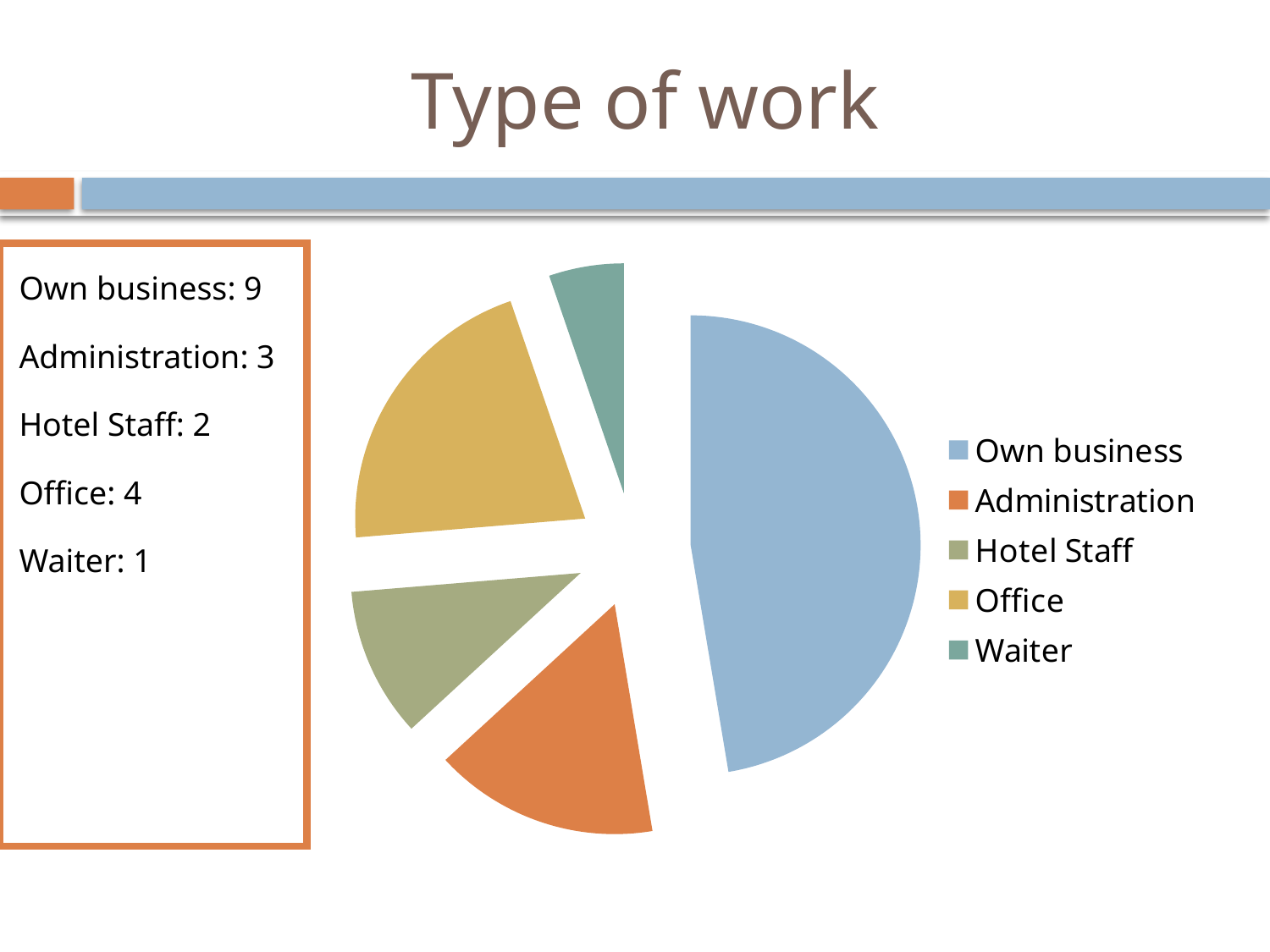
How many categories does the pie chart have? 5 Which is larger, Administration or Hotel Staff? Administration Which type of work has the smallest slice of the pie? Waiter Which type of work has the largest slice of the pie? Own business What is the difference between the values for Own business and Office? 5 What is the value for Office? 4 What type of chart is shown on the slide? Pie chart What is the value for Own business? 9 What is the value for Hotel Staff? 2 What is the value for Waiter? 1 What is the title of the slide containing the pie chart? Type of work What is the value for Administration? 3